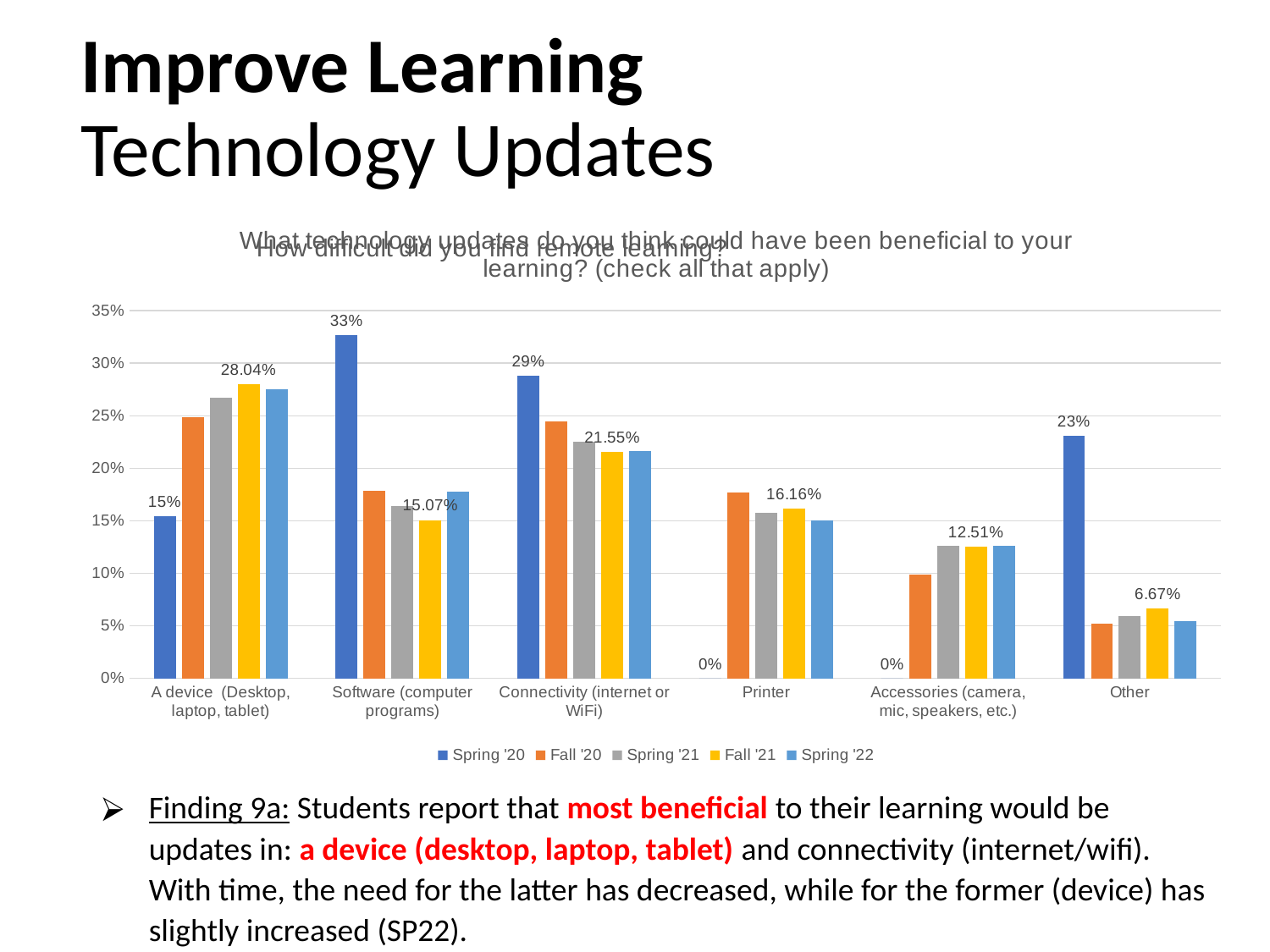
Which category has the highest Spring '20 value? Software (computer programs) Is the Spring '22 value for Software (computer programs) greater or less than 20%? less What is the difference between the Spring '20 values for Software (computer programs) and A device (Desktop, laptop, tablet)? 18 percentage points Which is larger for Spring '20: Connectivity (internet or WiFi) or Other? Connectivity (internet or WiFi) How many categories are shown on the x axis? 6 What kind of chart is shown on the slide? bar chart Which category has the lowest Fall '21 value? Other What is the Spring '20 value for Software (computer programs)? 33% What is the Spring '20 value for Accessories (camera, mic, speakers, etc.)? 0% How many series does the legend list? 5 What is the Fall '21 value for A device (Desktop, laptop, tablet)? 28.04% What is the Fall '21 value for Printer? 16.16%